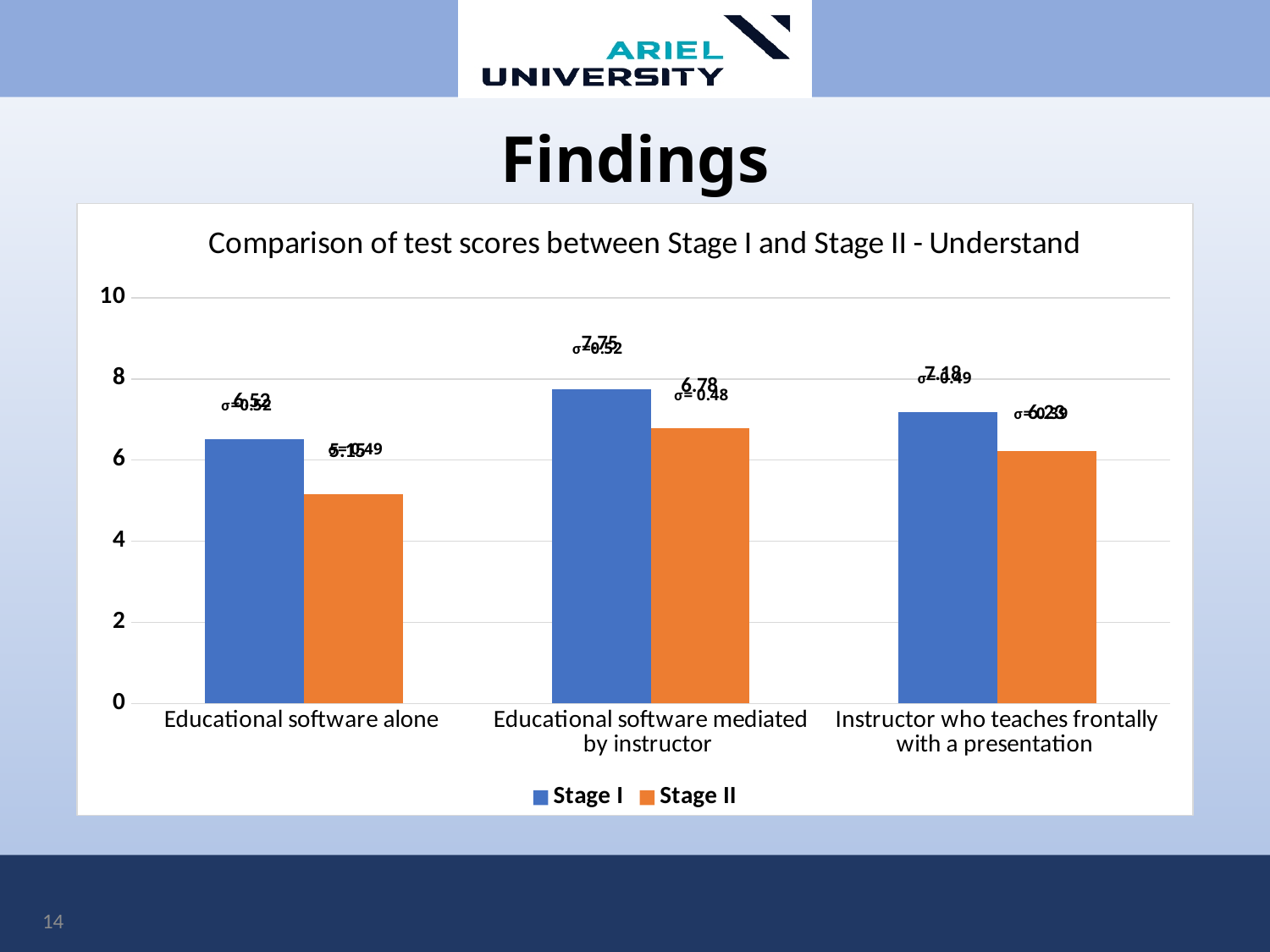
Which category has the lowest Stage II value? Educational software alone What type of chart is shown on the slide? Bar chart For 'Instructor who teaches frontally with a presentation', which is larger, the Stage I or the Stage II value? Stage I What is the difference between the Stage I and Stage II values for 'Educational software mediated by instructor'? 0.97 What is the Stage I value for 'Educational software alone'? 6.52 What is the Stage II value for 'Educational software mediated by instructor'? 6.78 Which category has the highest Stage I value? Educational software mediated by instructor What is the Stage I value for 'Educational software mediated by instructor'? 7.75 Is the Stage II value for 'Educational software alone' greater or less than 6? less How many series does the legend list? 2 What is the title of the chart? Comparison of test scores between Stage I and Stage II - Understand How many categories are shown on the x axis? 3